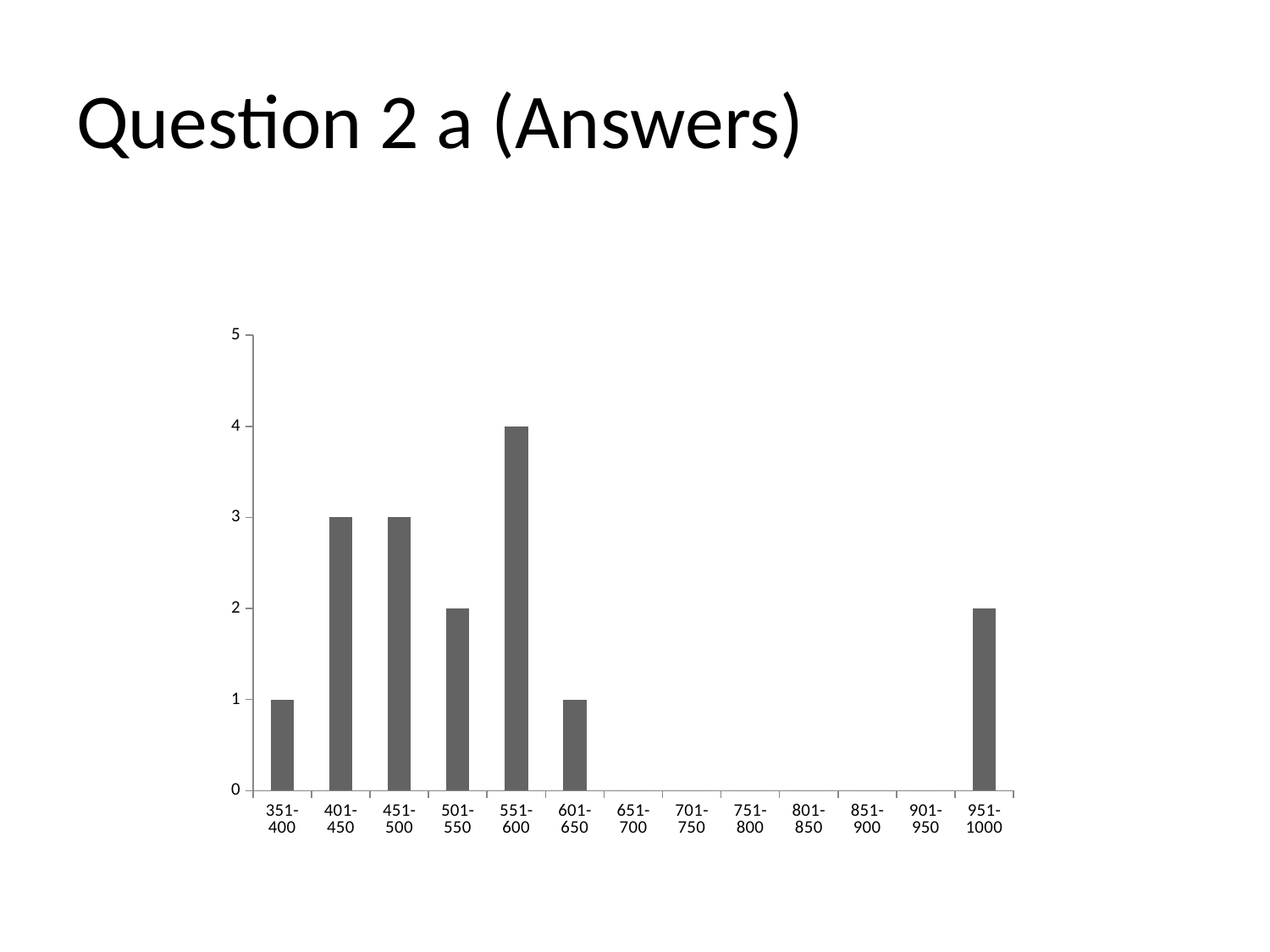
Which is larger, the value for 451-500 or the value for 601-650? 451-500 What is the value for the 401-450 category? 3 Which category has the highest bar in the chart? 551-600 What is the value for the 351-400 category? 1 How many categories between 651-700 and 901-950 have a visible bar? 0 What is the difference between the values for 551-600 and 501-550? 2 What is the title of the slide containing the chart? Question 2 a (Answers) What kind of chart is shown on the slide? bar chart How many categories are shown on the x axis of the chart? 13 Is the value for 551-600 greater or less than 3? greater What is the value for the 551-600 category? 4 What is the value for the 951-1000 category? 2